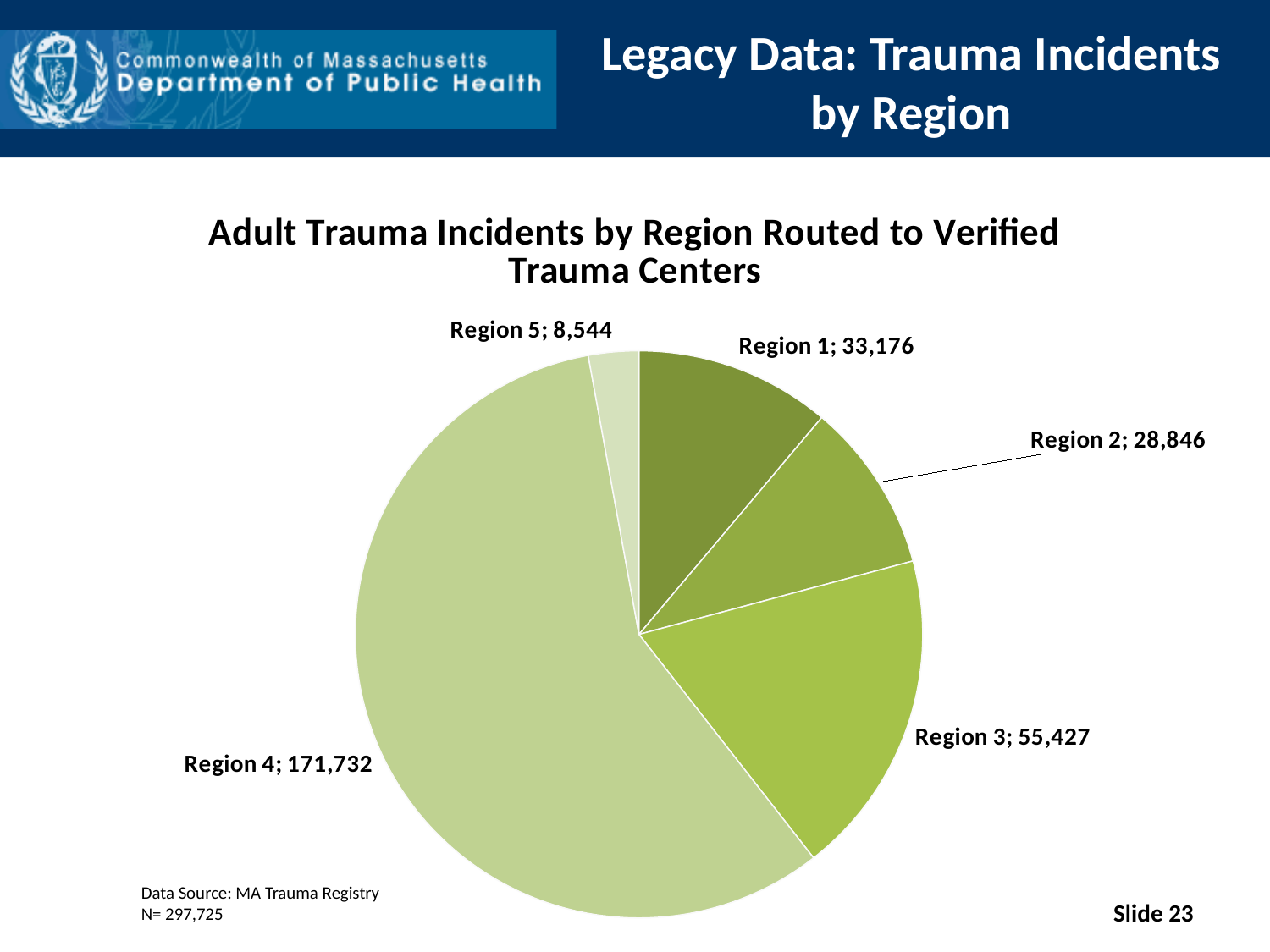
What is the title of the chart? Adult Trauma Incidents by Region Routed to Verified Trauma Centers Which region has the largest number of adult trauma incidents? Region 4 How many adult trauma incidents are shown for Region 4? 171,732 What is the difference between the number of incidents in Region 3 and Region 1? 22,251 How many adult trauma incidents are shown for Region 1? 33,176 How many adult trauma incidents are shown for Region 2? 28,846 Which region has the smallest number of adult trauma incidents? Region 5 What type of chart is shown on the slide? Pie chart How many adult trauma incidents are shown for Region 3? 55,427 How many regions are shown in the pie chart? 5 Which region has more adult trauma incidents, Region 1 or Region 2? Region 1 How many adult trauma incidents are shown for Region 5? 8,544